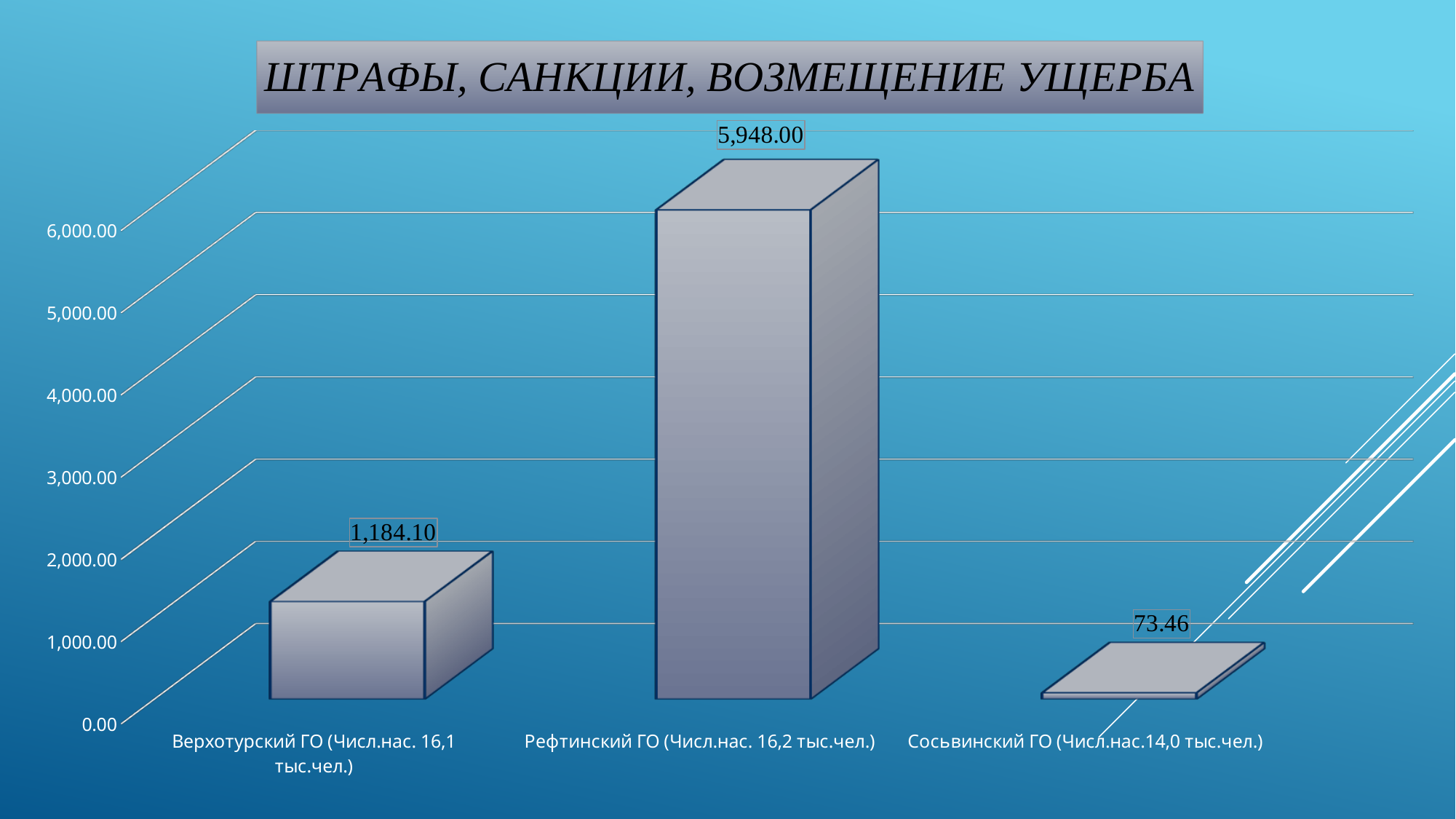
Is the value for Рефтинский ГО greater or less than 5,000.00? greater What kind of chart is shown on the slide? bar chart What is the value for Рефтинский ГО? 5,948.00 Which is larger, the value for Верхотурский ГО or the value for Сосьвинский ГО? Верхотурский ГО Which category has the highest value? Рефтинский ГО How many categories are shown in the chart? 3 What is the difference between the values for Верхотурский ГО and Сосьвинский ГО? 1,110.64 What is the title of the slide? ШТРАФЫ, САНКЦИИ, ВОЗМЕЩЕНИЕ УЩЕРБА What is the value for Сосьвинский ГО? 73.46 Which category has the lowest value? Сосьвинский ГО What is the value for Верхотурский ГО? 1,184.10 What is the difference between the values for Рефтинский ГО and Верхотурский ГО? 4,763.90